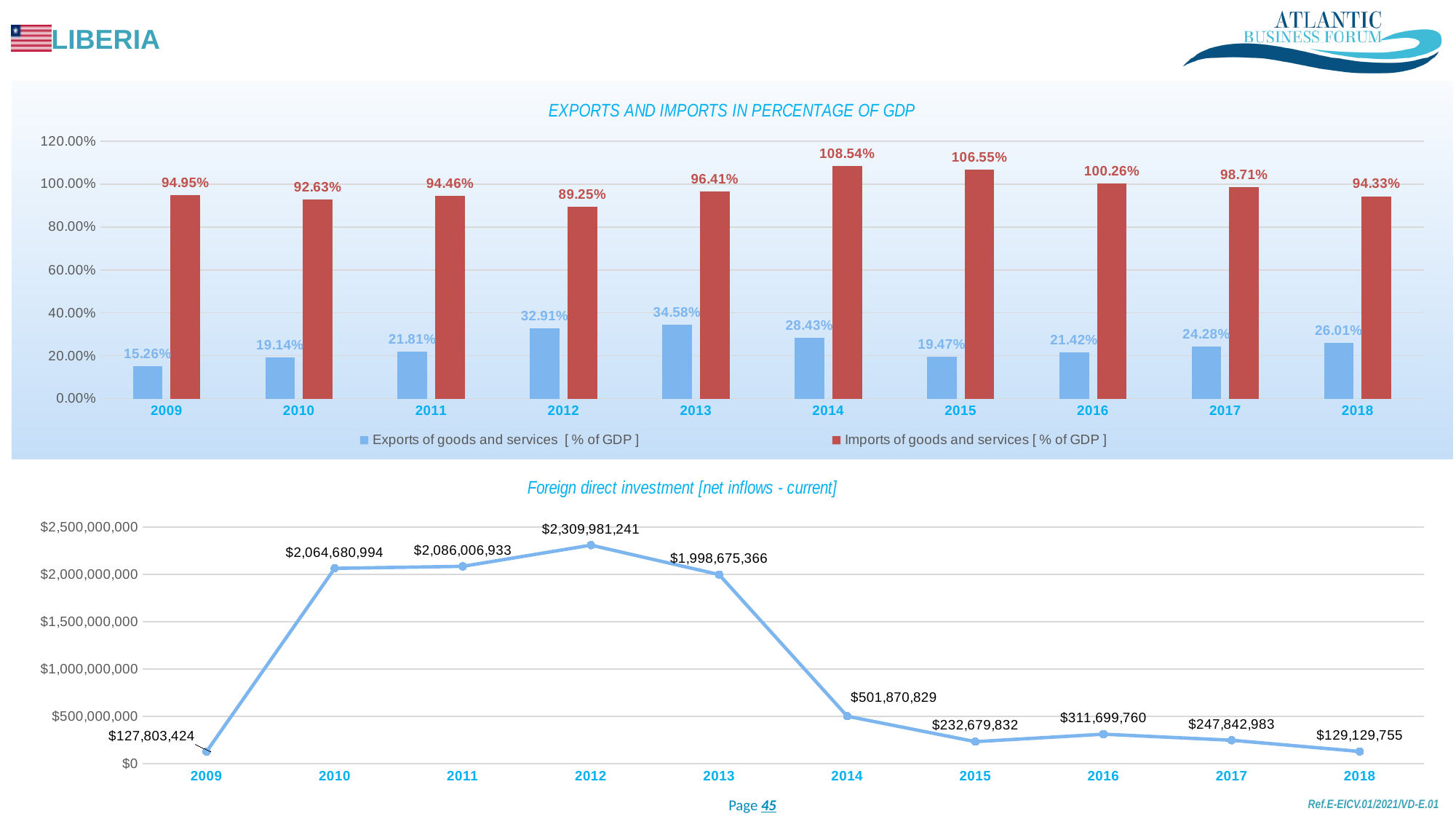
What kind of chart is the 'EXPORTS AND IMPORTS IN PERCENTAGE OF GDP' chart? Bar chart In the 'Foreign direct investment [net inflows - current]' chart, is the value for 2015 larger or smaller than the value for 2016? Smaller In the 'EXPORTS AND IMPORTS IN PERCENTAGE OF GDP' chart, what is the value of Exports of goods and services in 2013? 34.58% In the 'Foreign direct investment [net inflows - current]' chart, what is the value for 2012? $2,309,981,241 In the 'EXPORTS AND IMPORTS IN PERCENTAGE OF GDP' chart, which year has the highest Imports of goods and services value? 2014 In the 'EXPORTS AND IMPORTS IN PERCENTAGE OF GDP' chart, which year has the lowest Exports of goods and services value? 2009 In the 'EXPORTS AND IMPORTS IN PERCENTAGE OF GDP' chart, what is the difference between Imports and Exports of goods and services in 2012? 56.34% In the 'Foreign direct investment [net inflows - current]' chart, do the values rise or fall from 2013 to 2015? Fall How many series does the legend of the 'EXPORTS AND IMPORTS IN PERCENTAGE OF GDP' chart list? 2 In the 'EXPORTS AND IMPORTS IN PERCENTAGE OF GDP' chart, what is the value of Imports of goods and services in 2014? 108.54% In the 'Foreign direct investment [net inflows - current]' chart, which year has the lowest value? 2009 How many years are plotted in the 'Foreign direct investment [net inflows - current]' chart? 10